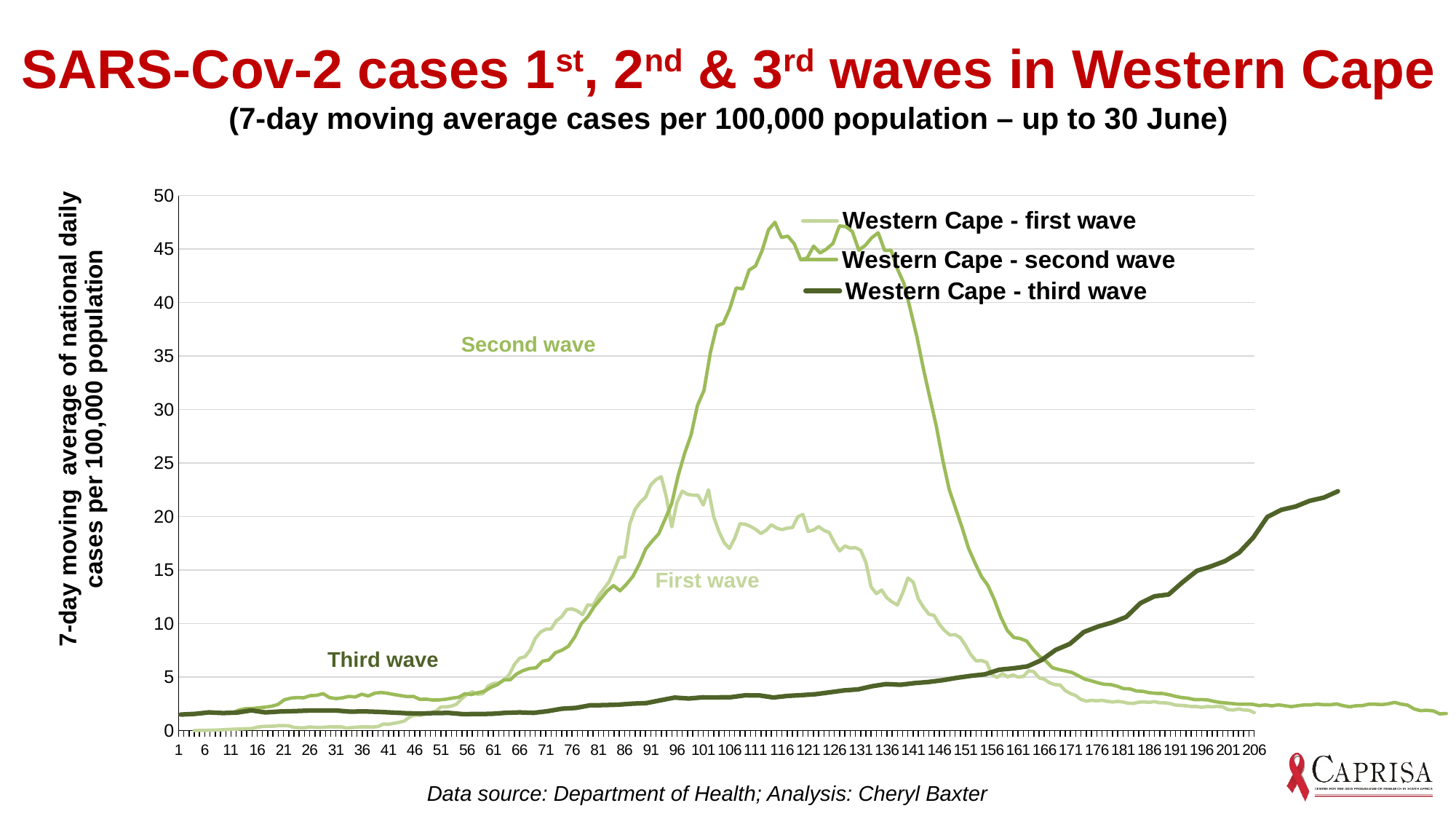
What is the maximum value shown on the y axis? 50 Is the peak value of the Western Cape - first wave series greater or less than 20? greater Which series has the highest value at day 206? Western Cape - third wave Is the final value of the Western Cape - third wave series (at day 206) greater or less than 20? greater Which series reaches the highest peak value on the chart? Western Cape - second wave What is the title of the chart on the slide? SARS-Cov-2 cases 1st, 2nd & 3rd waves in Western Cape At day 101, which is larger: the Western Cape - first wave value or the Western Cape - second wave value? Western Cape - second wave How many series does the legend list? 3 At day 181, which is larger: the Western Cape - second wave value or the Western Cape - third wave value? Western Cape - third wave Does the Western Cape - third wave series rise or fall along the x axis? rises What kind of chart is shown on the slide? Line chart Is the peak value of the Western Cape - second wave series greater or less than 40? greater